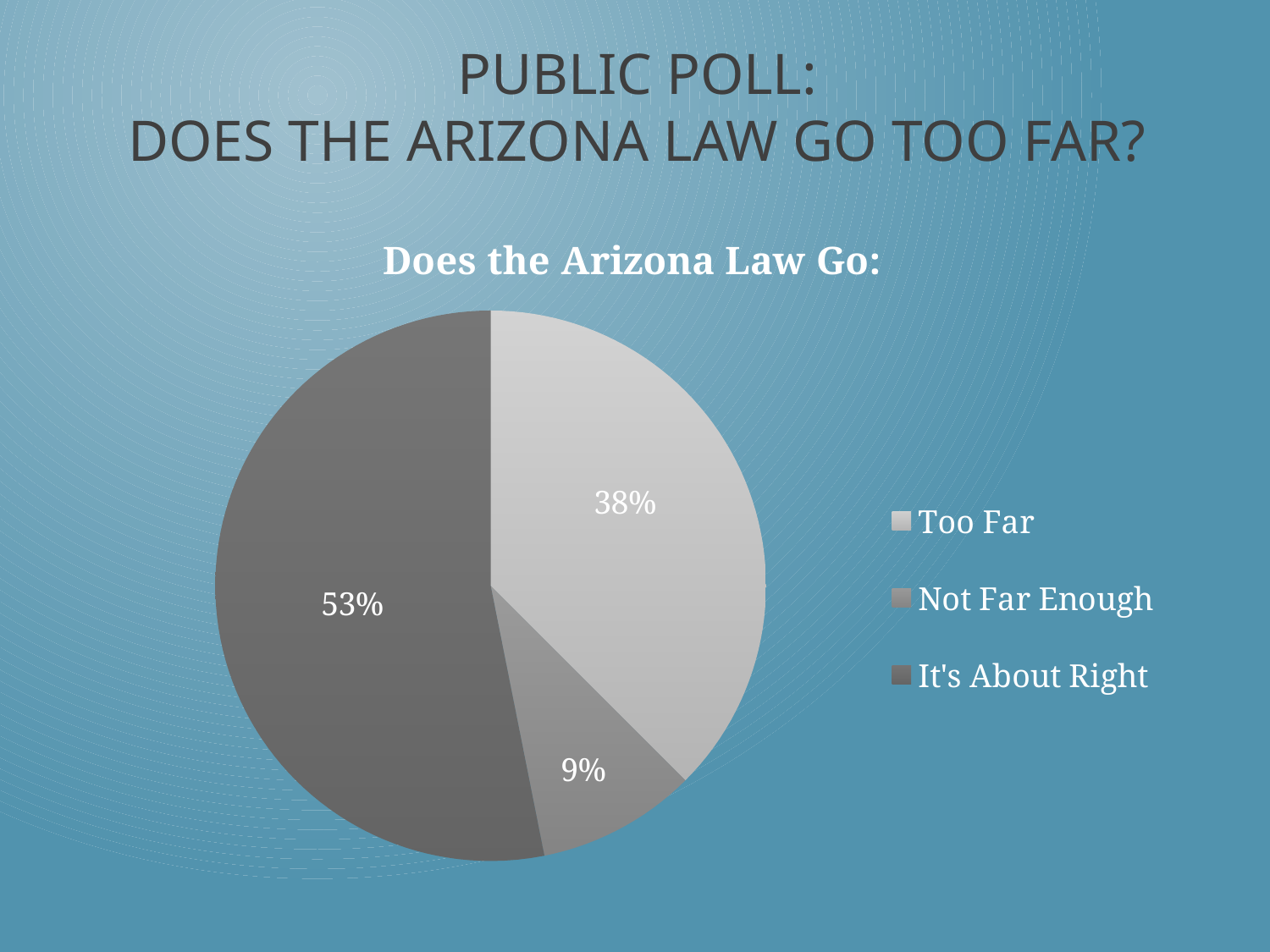
What is the title of the chart? Does the Arizona Law Go: What share of the pie is labelled "It's About Right"? 53% What is the difference in percentage points between "It's About Right" and "Too Far"? 15 What share of the pie is labelled "Too Far"? 38% What is the difference in percentage points between "Too Far" and "Not Far Enough"? 29 Which is larger, the share for "Too Far" or the share for "Not Far Enough"? Too Far What share of the pie is labelled "Not Far Enough"? 9% How many slices does the pie chart have? 3 What kind of chart is shown on the slide? Pie chart Which response has the smallest share of the pie? Not Far Enough How many entries does the legend list? 3 Which response has the largest share of the pie? It's About Right